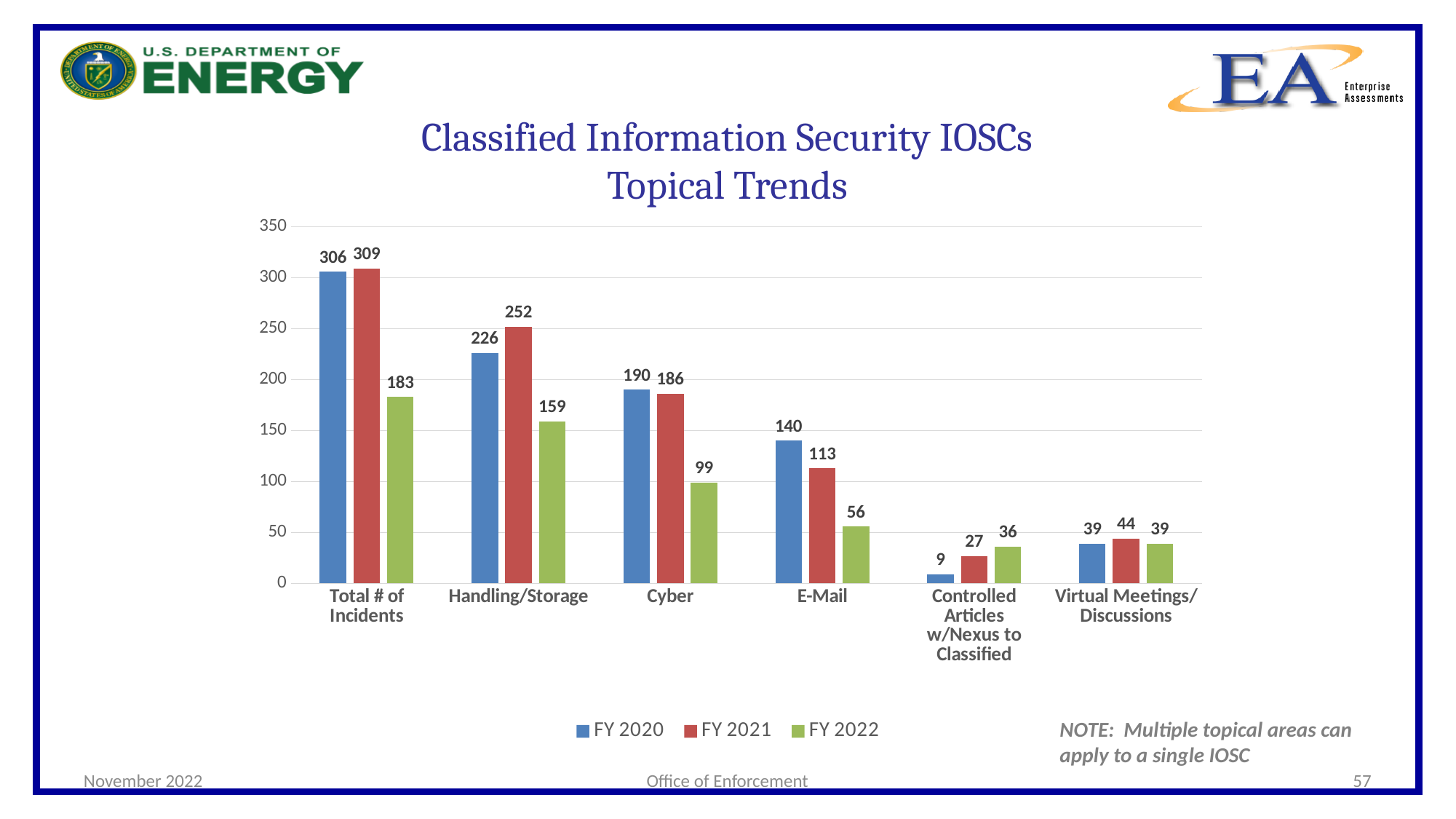
Which colour represents FY 2022 in the chart? Green Is the FY 2022 value for Handling/Storage greater or less than 150? greater How many categories are shown on the x axis? 6 Which is larger for Virtual Meetings/Discussions: the FY 2021 value or the FY 2022 value? FY 2021 What is the FY 2022 value for Cyber? 99 How many series does the legend list? 3 What kind of chart is shown on the slide? Bar chart Which category has the lowest FY 2020 value? Controlled Articles w/Nexus to Classified What is the FY 2021 value for Handling/Storage? 252 What is the FY 2020 value for Controlled Articles w/Nexus to Classified? 9 Which category has the highest FY 2022 value? Total # of Incidents What is the difference between the FY 2020 and FY 2022 values for E-Mail? 84